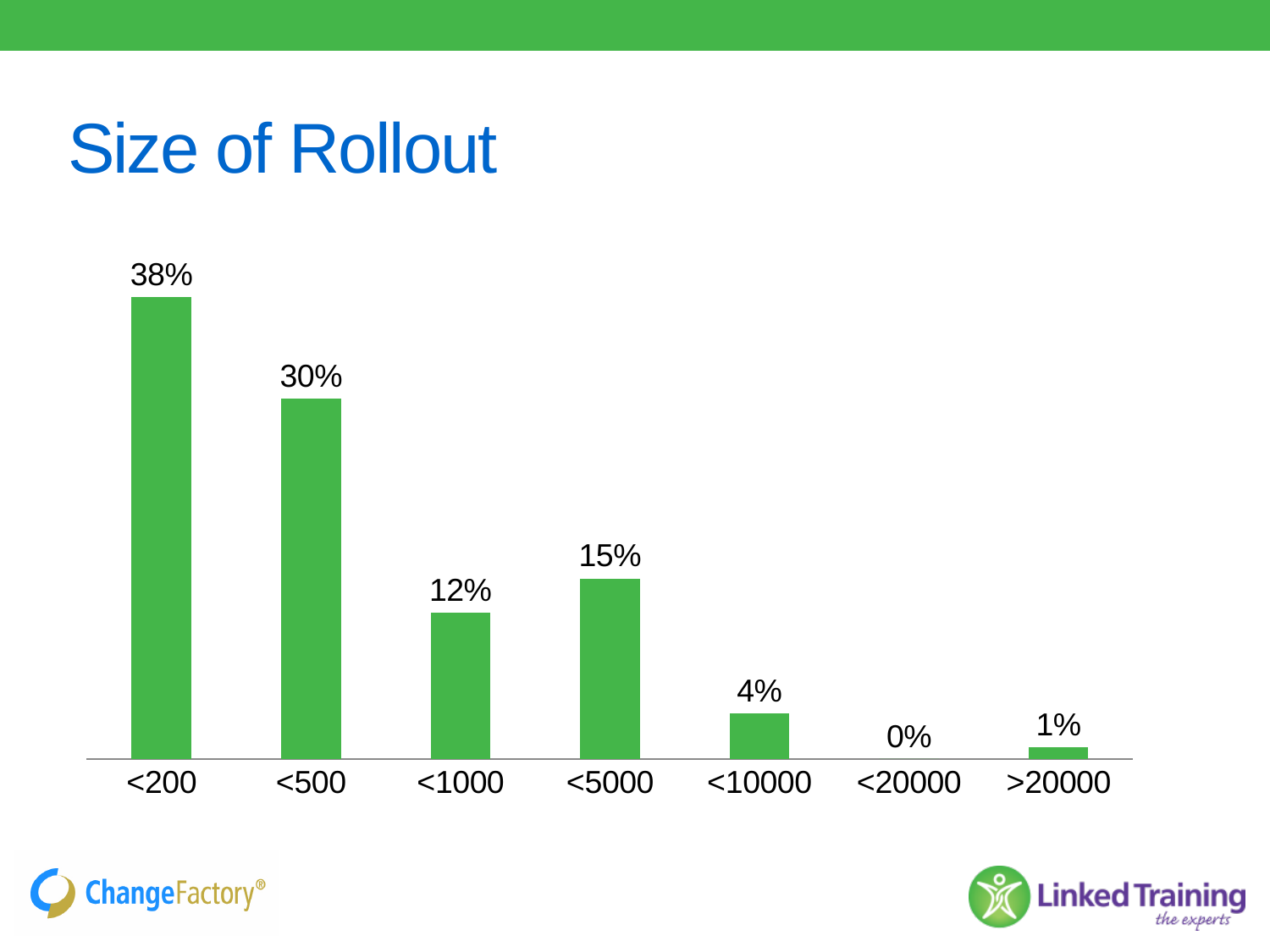
What is the value for the <500 category? 30% Which category has the highest value? <200 Which category has the lowest value? <20000 How many categories are shown on the x axis? 7 What is the value for the <20000 category? 0% What is the difference between the values for <200 and <500? 8% What kind of chart is shown on the slide? Bar chart What is the title of the slide? Size of Rollout Which is larger, the value for <1000 or the value for <5000? <5000 What is the difference between the values for <5000 and <1000? 3% What is the value for the <200 category? 38% What is the value for the <5000 category? 15%